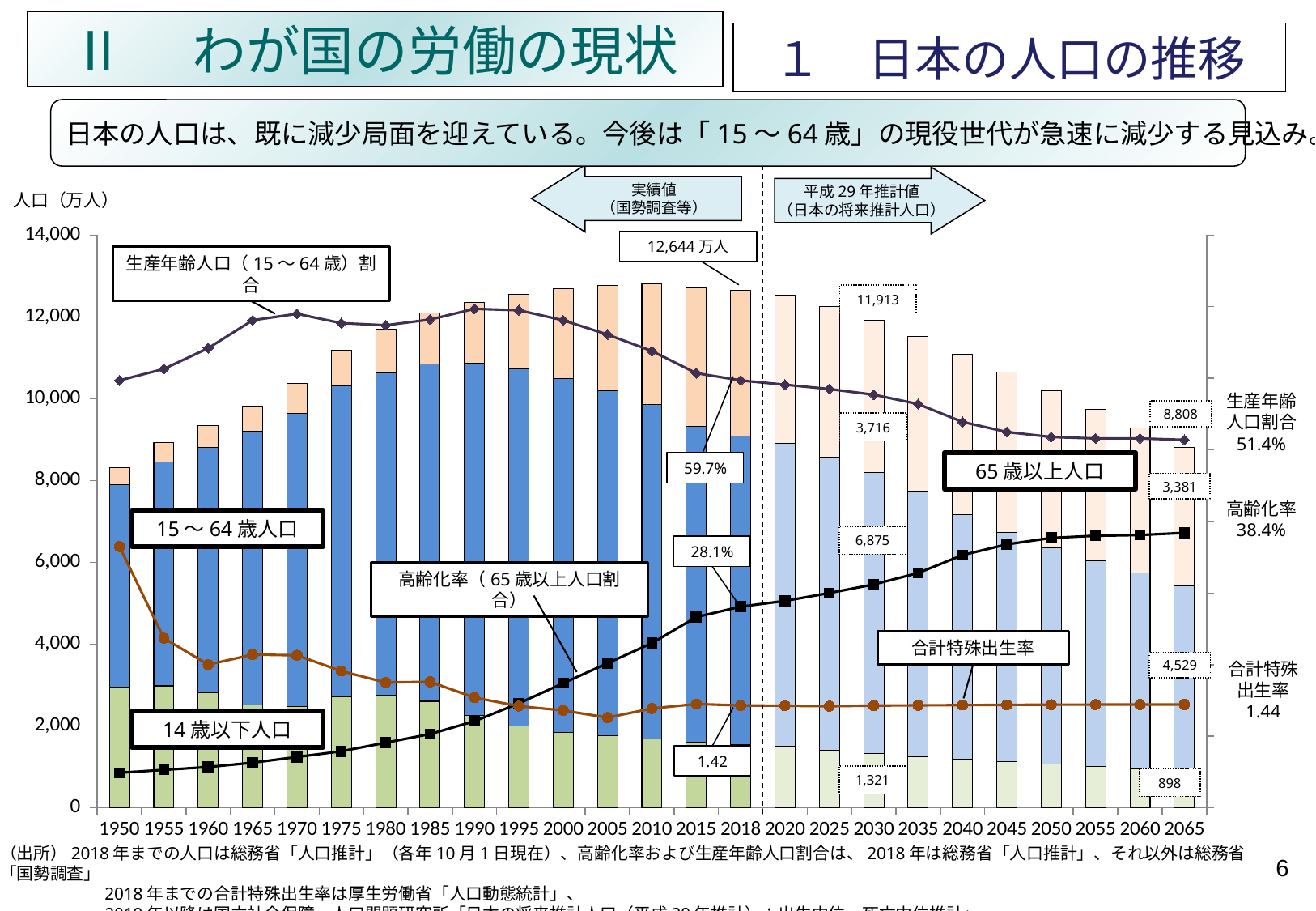
What is the 15～64歳人口 value labelled for 2030? 6,875 What is the total population value labelled for 2065? 8,808 What is the total population shown for 2018 on the chart? 12,644万人 What is the 生産年齢人口割合 shown for 2065? 51.4% Is the total population bar for 1950 greater or less than 8,000? greater What is the total population value labelled for 2030? 11,913 What is the 合計特殊出生率 shown for 2018? 1.42 What is the 高齢化率 (aging rate) shown for 2018? 28.1% What is the 65歳以上人口 value labelled for 2065? 3,381 What is the 14歳以下人口 value labelled for 2065? 898 Does the 高齢化率 line rise or fall from 1950 to 2065? rises By how much does the labelled total population fall from 2030 (11,913) to 2065 (8,808)? 3,105